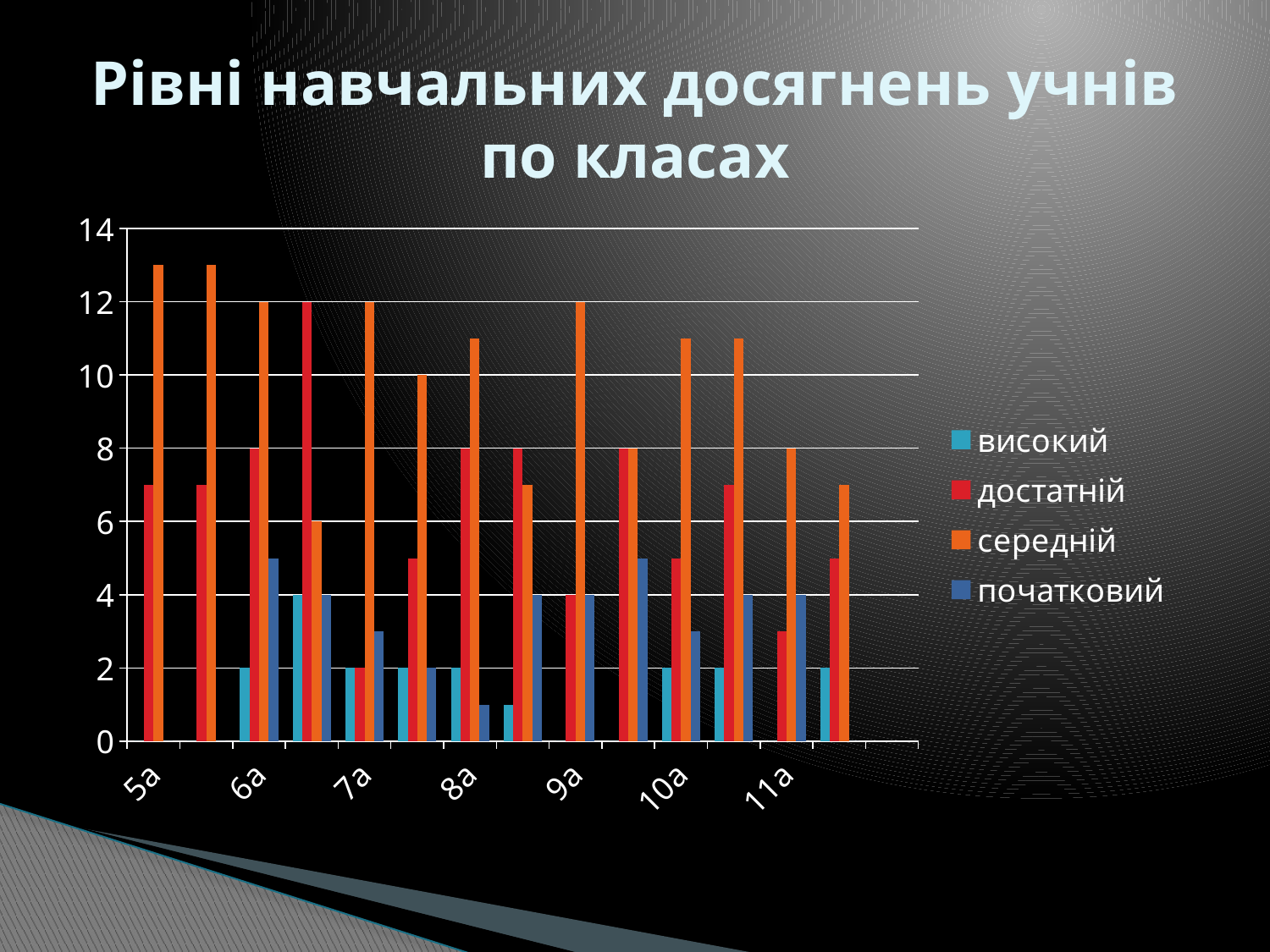
What is the value of 'високий' for class 7а? 2 What kind of chart is shown on the slide? bar chart Is the value of 'середній' for class 5а greater or less than 12? greater How many series does the legend list? 4 What is the title of the chart? Рівні навчальних досягнень учнів по класах For class 6а, which is larger: 'середній' or 'достатній'? середній What is the value of 'середній' for class 9а? 12 Is the value of 'початковий' for class 6а greater or less than 4? greater Which colour represents the series 'середній' in the legend? orange For class 8а, which series has the lowest value? початковий What is the value of 'достатній' for class 6а? 8 What is the value of 'середній' for class 6а? 12